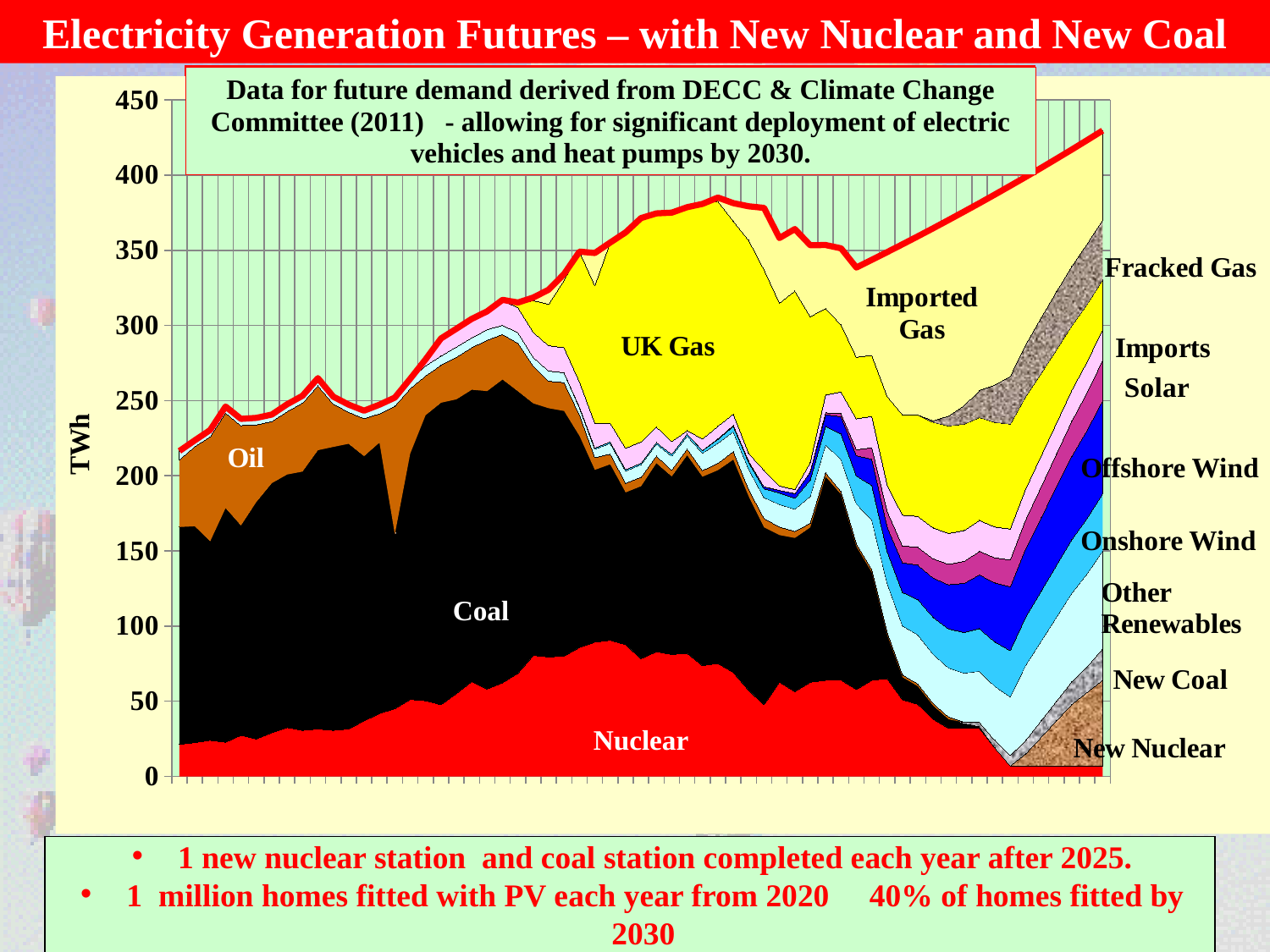
What is the highest value shown on the y-axis of the chart? 450 What kind of chart is shown on the slide? Stacked area chart Is the total generation at the far right end of the chart greater or less than 400 TWh? greater How many generation sources are labelled on the chart? 13 Does the total generation (red line) rise or fall towards the right-hand end of the chart? Rise Is the Coal layer at the right-hand end of the chart greater or less than 50 TWh? less Is the total generation at the far left end of the chart greater or less than 250 TWh? less Which generation source is the top layer of the stack at the right-hand end of the chart? Imported Gas Which generation source forms the bottom layer of the stacked area chart? Nuclear What unit is shown on the y-axis of the chart? TWh